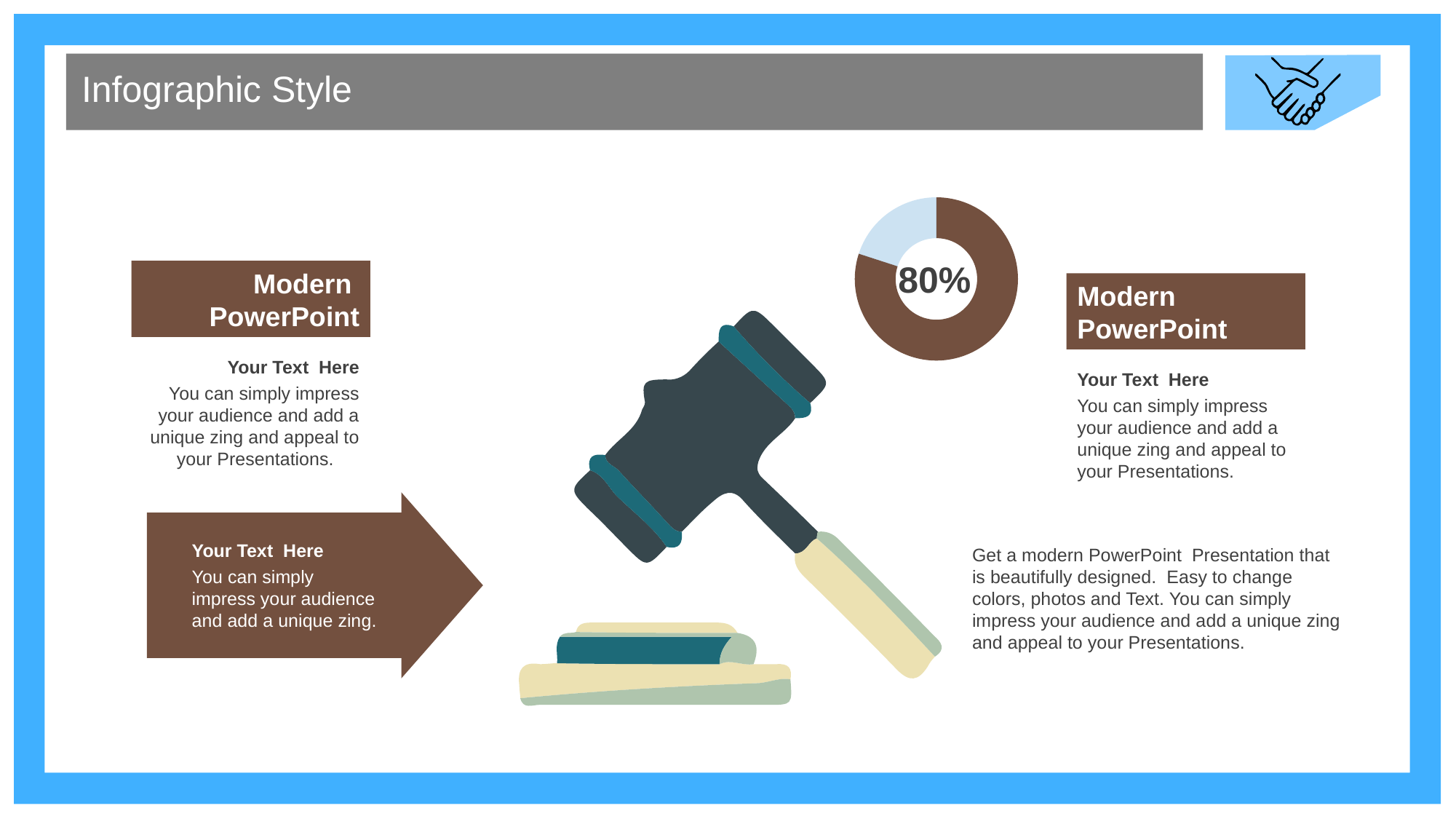
What percentage is printed in the centre of the doughnut chart? 80% What kind of chart is shown on the slide? doughnut chart What colour is the larger segment of the doughnut chart? brown What share of the doughnut chart does the brown segment represent? 80% Is the value shown in the doughnut chart greater or less than 50%? greater How many segments does the doughnut chart have? 2 Does the doughnut chart have a legend? No What share of the doughnut chart does the light blue segment represent? 20% Which segment of the doughnut chart is larger, the brown one or the light blue one? brown